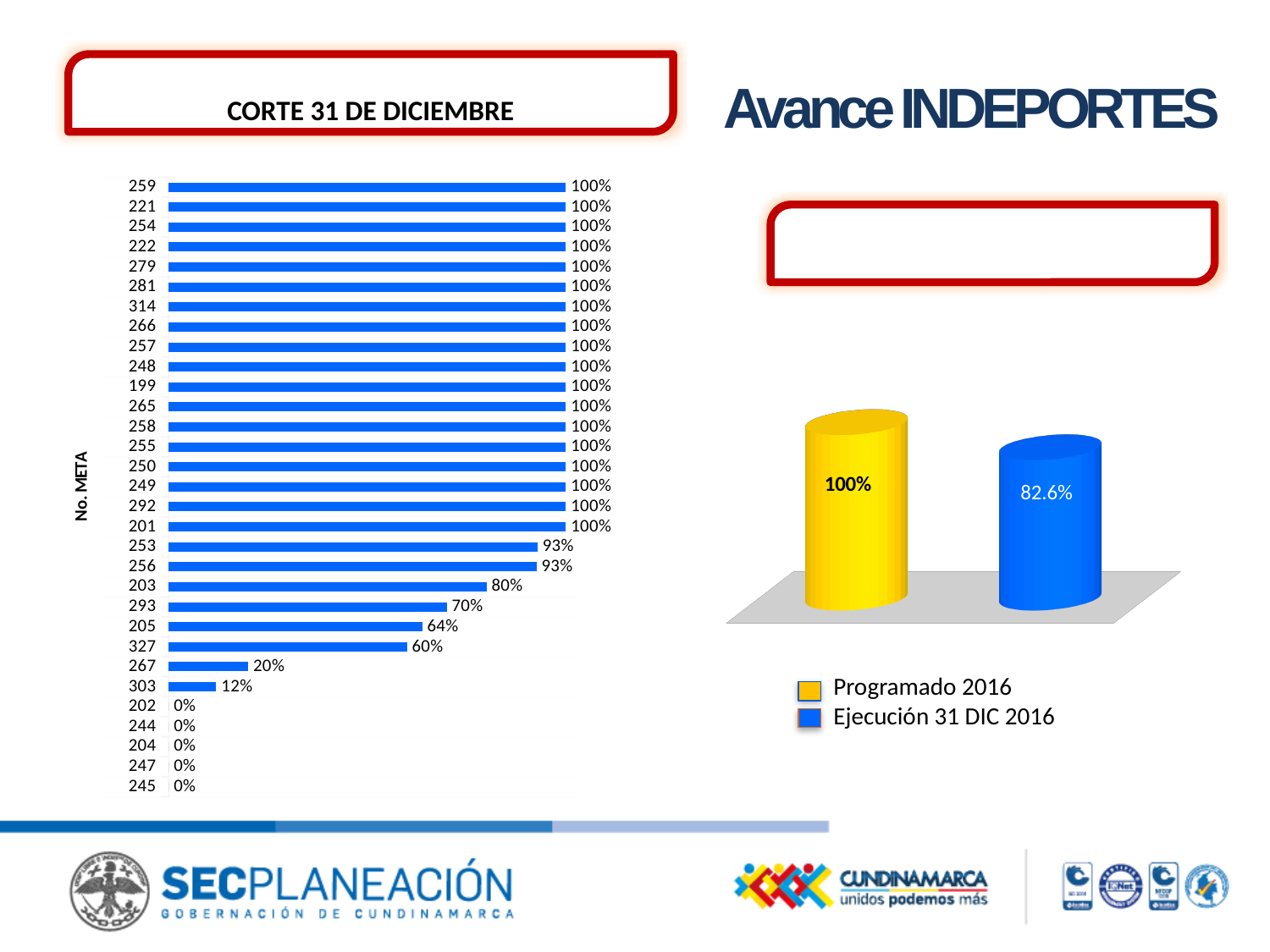
In the left chart (CORTE 31 DE DICIEMBRE), what is the value for meta 303? 12% How many entries does the legend of the right chart list? 2 In the left chart (CORTE 31 DE DICIEMBRE), how many metas have a value of 0%? 5 In the right chart, what is the value for Ejecución 31 DIC 2016? 82.6% In the left chart (CORTE 31 DE DICIEMBRE), what is the difference between the values for meta 293 and meta 205? 6% In the left chart (CORTE 31 DE DICIEMBRE), which has the larger value, meta 267 or meta 303? 267 What kind of chart is the left chart (CORTE 31 DE DICIEMBRE)? Bar chart In the left chart (CORTE 31 DE DICIEMBRE), how many metas are listed in total? 31 In the left chart (CORTE 31 DE DICIEMBRE), what is the value for meta 203? 80% In the right chart, what is the value for Programado 2016? 100% In the right chart, which is larger, Programado 2016 or Ejecución 31 DIC 2016? Programado 2016 In the left chart (CORTE 31 DE DICIEMBRE), what is the value for meta 327? 60%